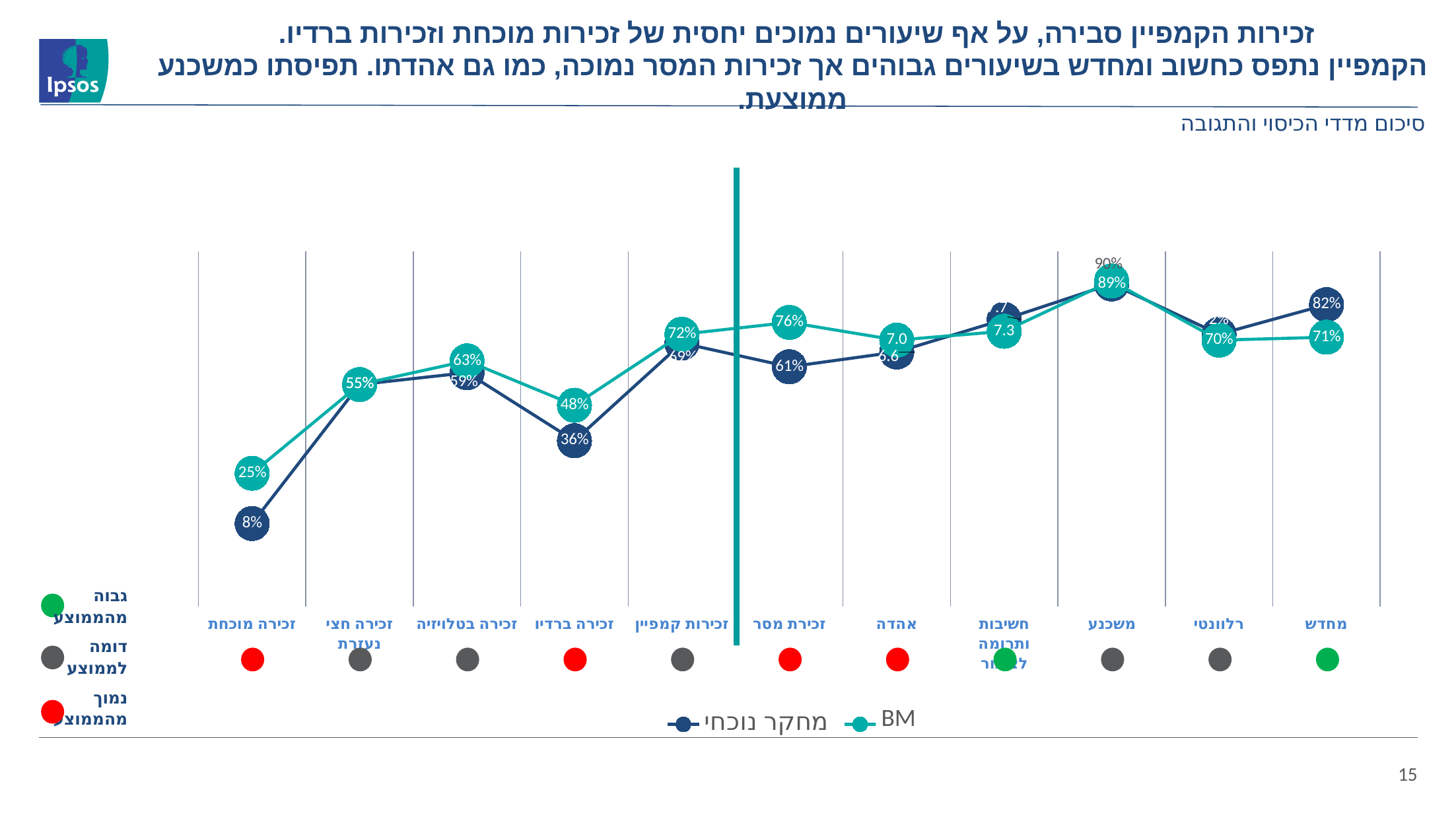
How many categories are plotted along the x axis of the chart? 11 What is the value of the מחקר נוכחי series for זכירה מוכחת? 8% What is the BM value for זכירת מסר? 76% Which series is drawn in teal in the chart? BM For מחדש, which series has the larger value, מחקר נוכחי or BM? מחקר נוכחי What kind of chart is shown on the slide? line chart How many series does the chart legend list? 2 What is the מחקר נוכחי value for מחדש? 82% What is the difference between the BM value and the מחקר נוכחי value for זכירה ברדיו? 12% Which category has the lowest מחקר נוכחי value? זכירה מוכחת What is the מחקר נוכחי value for זכירה ברדיו? 36% What is the BM value for זכירה מוכחת? 25%